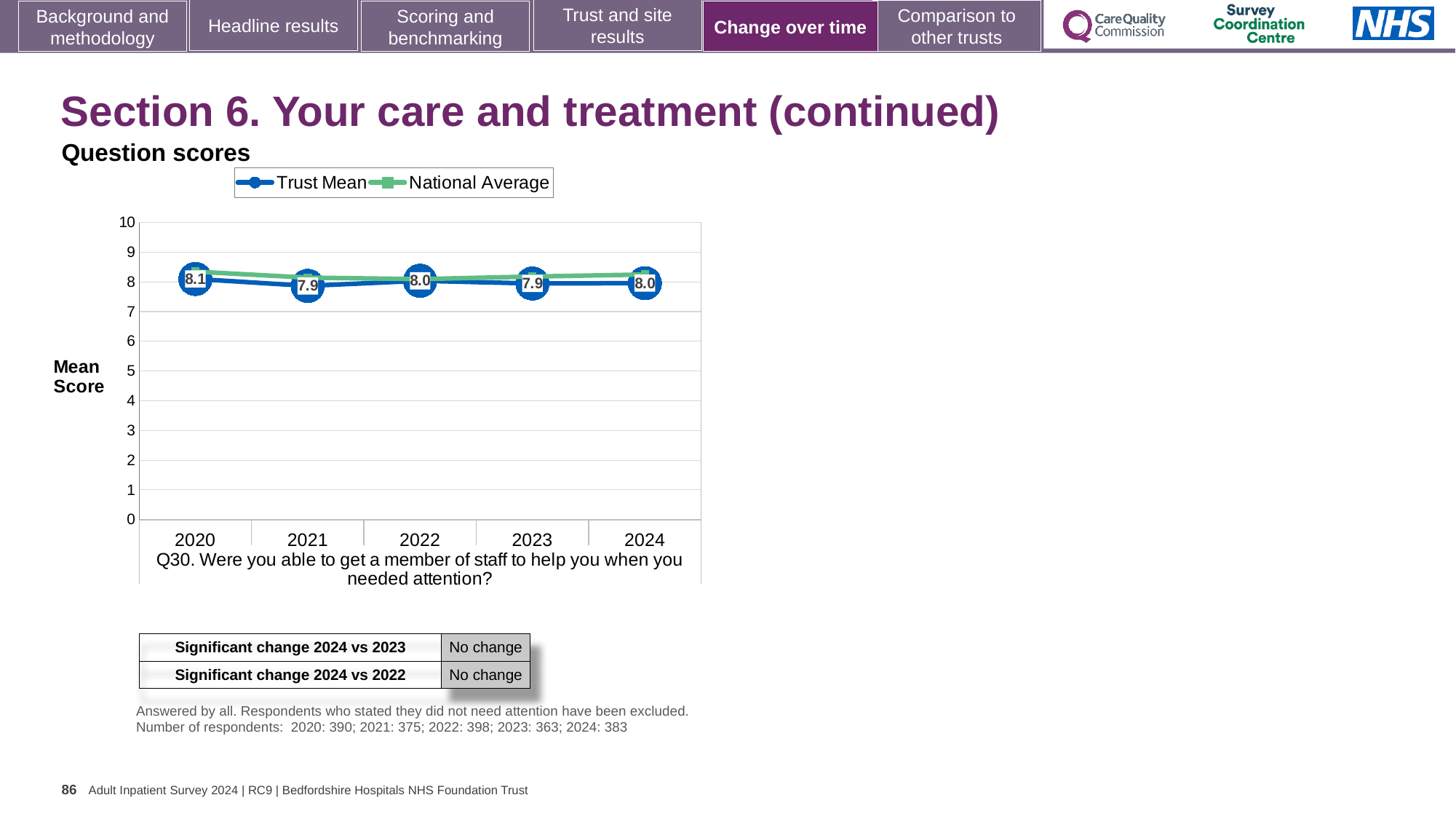
How many series does the chart legend list? 2 What is the Trust Mean score for 2021? 7.9 Which is larger, the Trust Mean score for 2020 or for 2022? 2020 In which year is the Trust Mean score highest? 2020 What kind of chart is shown on the slide? Line chart What is the Trust Mean score for 2022? 8.0 What is the Trust Mean score for 2024? 8.0 What is the label of the y axis of the chart? Mean Score How many years are shown on the x axis of the chart? 5 What is the Trust Mean score for 2020? 8.1 Is the National Average value for 2024 greater or less than 7? greater What is the difference between the Trust Mean score in 2020 and in 2021? 0.2